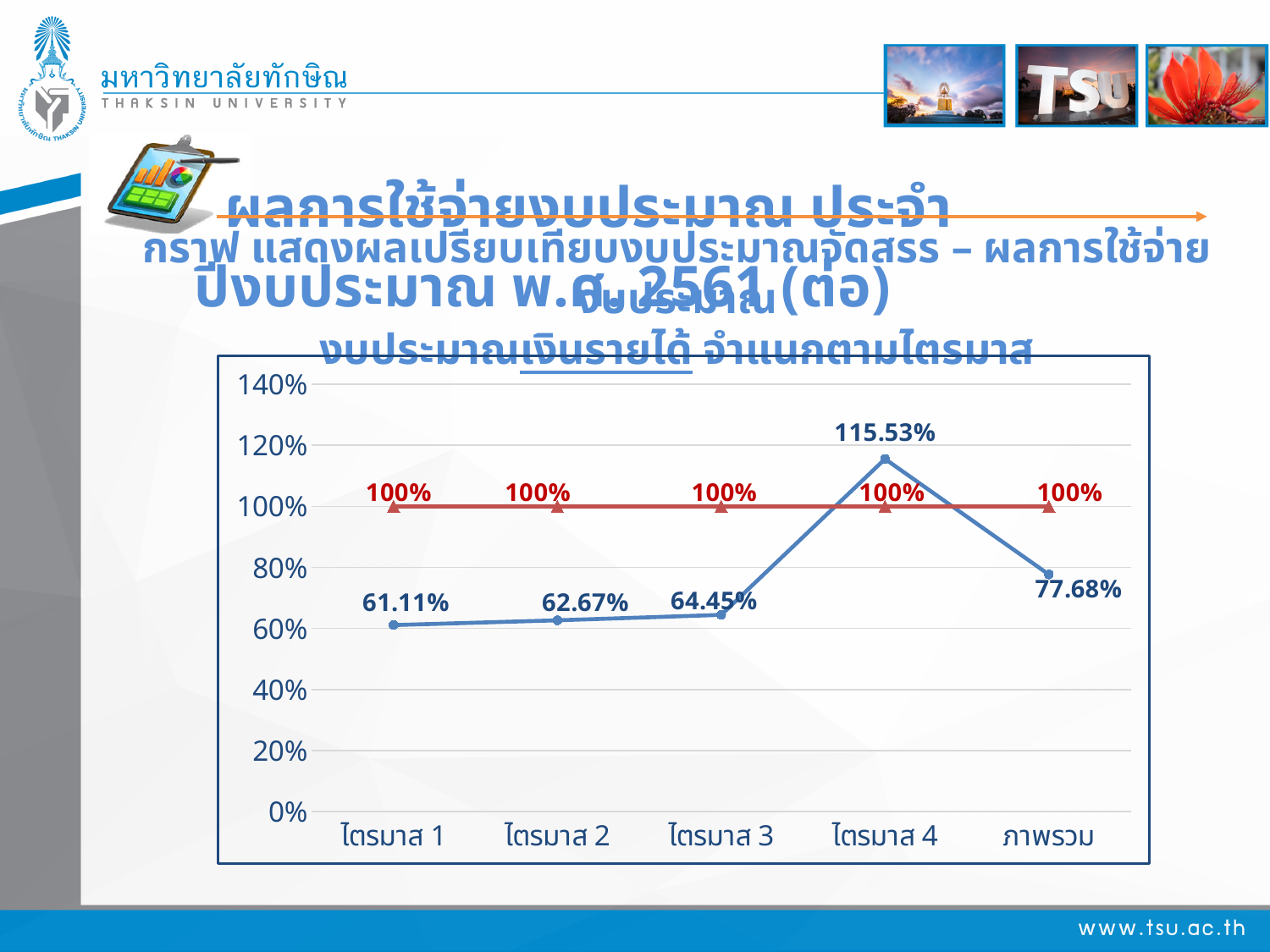
What is the value of the blue line for ภาพรวม? 77.68% Which category has the highest value on the blue line? ไตรมาส 4 What is the value of the blue line for ไตรมาส 4? 115.53% What type of chart is shown on the slide? line chart What is the value of the red line for ไตรมาส 3? 100% Which category has the lowest value on the blue line? ไตรมาส 1 What is the title of the chart? งบประมาณเงินรายได้ จำแนกตามไตรมาส How many categories are shown on the x axis? 5 Which is larger, the blue line value for ไตรมาส 2 or for ไตรมาส 3? ไตรมาส 3 What is the difference between the blue line values for ไตรมาส 4 and ไตรมาส 1? 54.42% What is the value of the blue line for ไตรมาส 1? 61.11% Does the blue line rise or fall from ไตรมาส 1 to ไตรมาส 3? rise